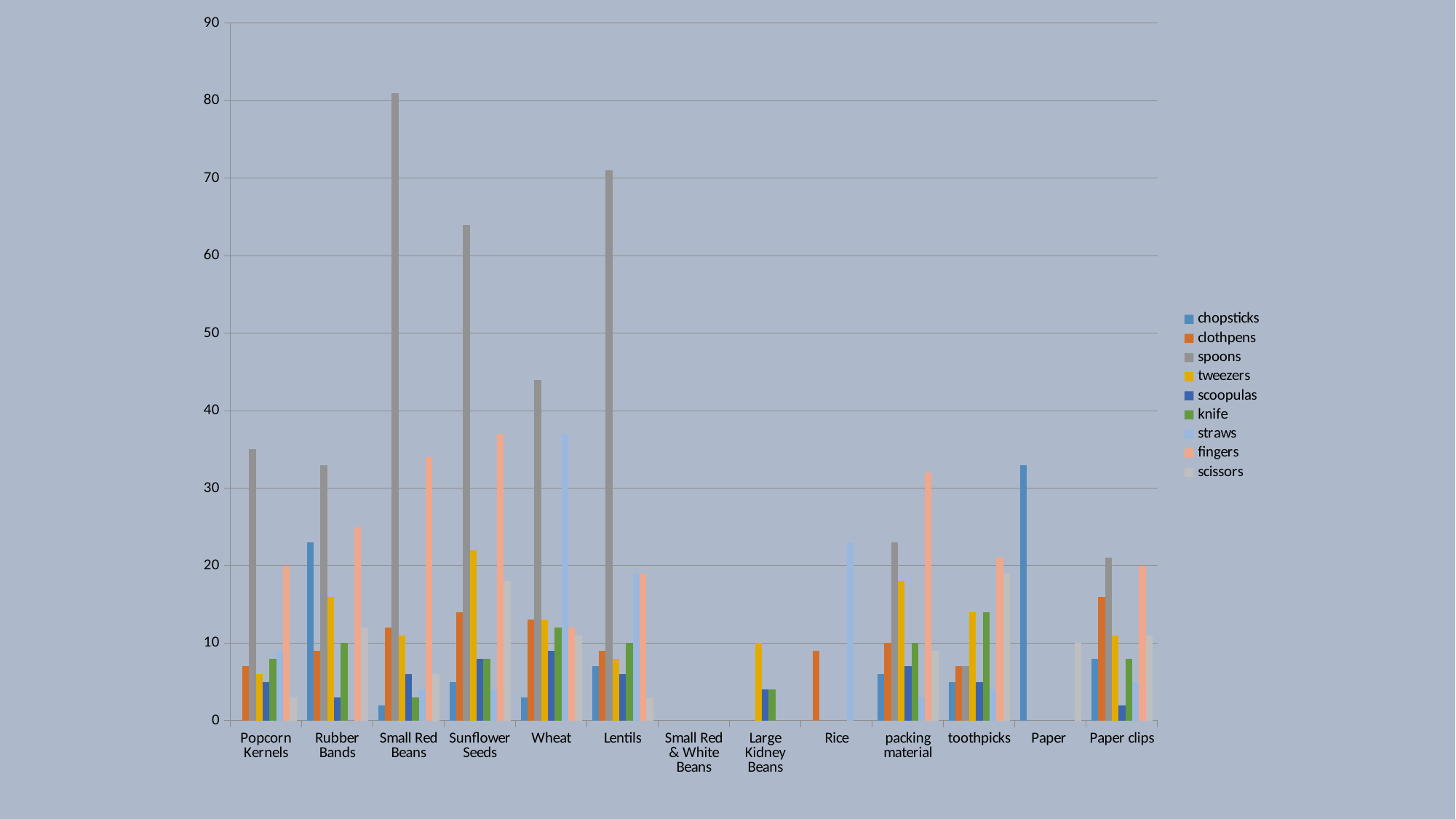
Is the value for spoons for Wheat greater or less than 50? less Which is larger, the spoons value for Lentils or the spoons value for Wheat? Lentils What kind of chart is shown on the slide? bar chart Is the value for spoons for Small Red Beans greater or less than 70? greater Is the value for straws for Rice greater or less than 20? greater Which category has the highest value for spoons? Small Red Beans Which series is listed last in the legend? scissors How many series does the legend list? 9 How many categories are shown along the x axis? 13 Which category has the highest value for chopsticks? Paper